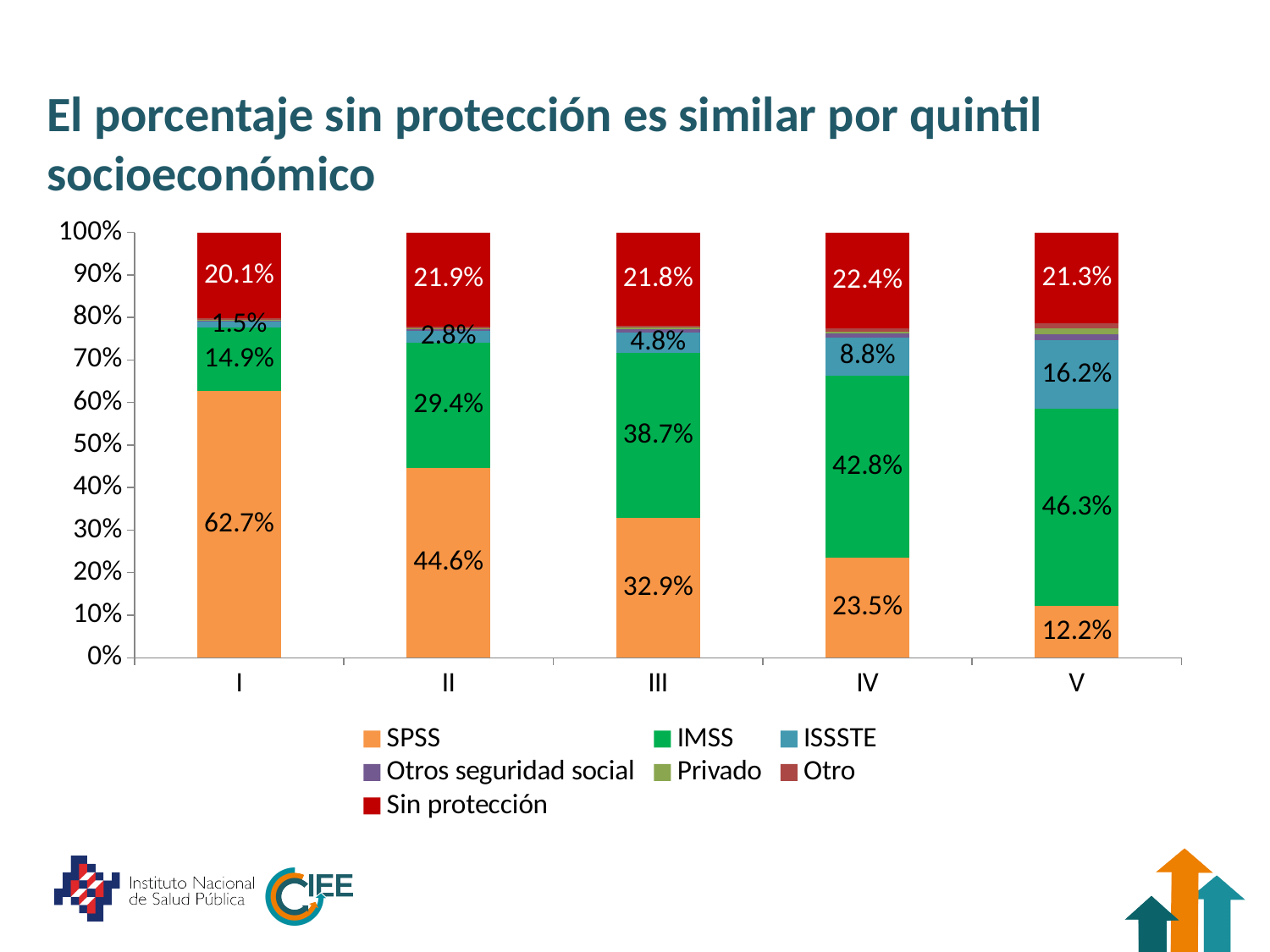
What is the IMSS value for quintile V? 46.3% How many quintile categories are shown on the x axis? 5 Which quintile has the highest SPSS value? I What is the ISSSTE value for quintile IV? 8.8% What kind of chart is shown on the slide? Stacked bar chart Which quintile has the lowest IMSS value? I What is the Sin protección value for quintile II? 21.9% Do the SPSS values rise or fall from quintile I to quintile V? Fall What is the SPSS value for quintile I? 62.7% Which is larger, the IMSS value for quintile III or the IMSS value for quintile IV? IMSS for quintile IV How many series does the legend list? 7 What is the difference between the SPSS values for quintile I and quintile V? 50.5%